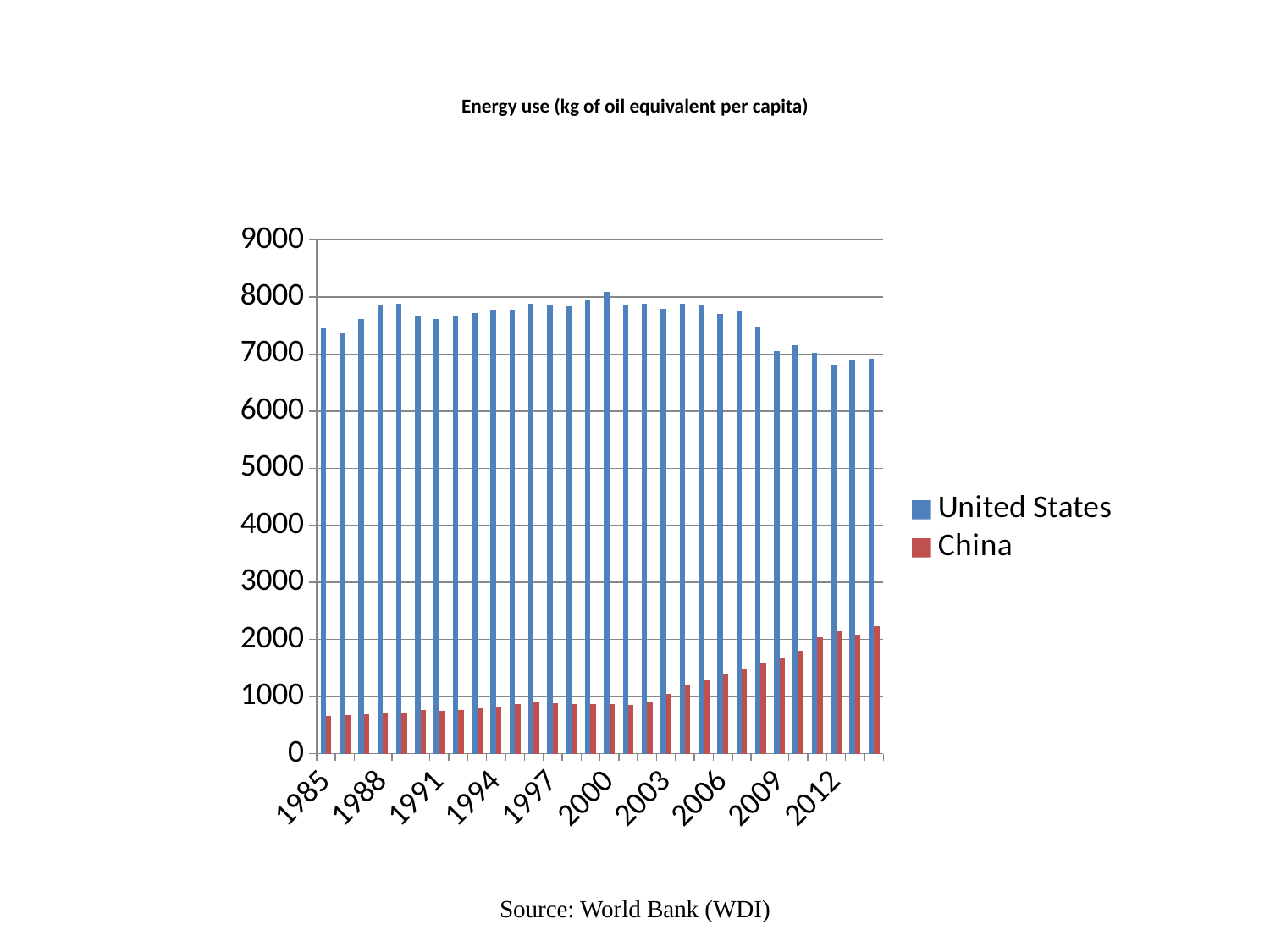
Do the values for the United States rise or fall from 2006 to 2012? fall What kind of chart is shown on the slide? bar chart How many series does the legend list? 2 Do the values for China rise or fall from 1985 to 2012? rise Which series is shown in red? China Is the value for the United States in 2006 greater or less than 7000? greater What is the title of the chart? Energy use (kg of oil equivalent per capita) Is the value for the United States in 2012 greater or less than 7000? less Is the value for China in 1985 greater or less than 1000? less Which is larger in 2012, the value for the United States or the value for China? United States